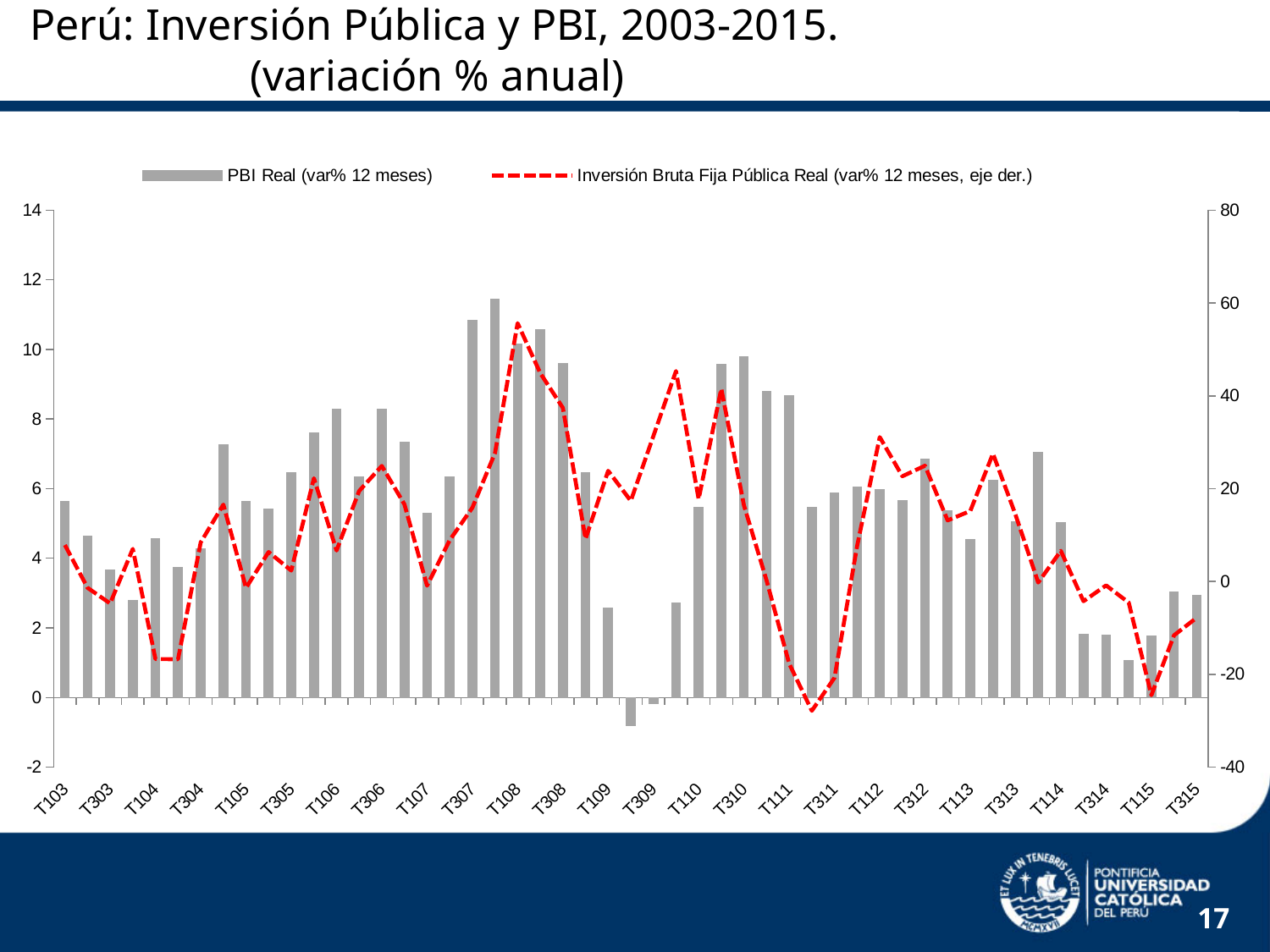
Do the PBI Real bars rise or fall from T114 to T115? Fall Does the Inversión Bruta Fija Pública Real line rise or fall between T309 and T110? Falls Is the PBI Real value for T315 greater or less than 4? less Is the PBI Real value for T103 greater or less than 4? greater Is the Inversión Bruta Fija Pública Real value at T108 greater or less than 40 on the right axis? greater Which series is plotted as grey bars? PBI Real (var% 12 meses) Which is larger, the PBI Real bar for T103 or the PBI Real bar for T315? T103 What kind of chart is shown on the slide? A combined bar and line chart How many series does the legend list? 2 Which series is drawn as a dashed red line? Inversión Bruta Fija Pública Real (var% 12 meses, eje der.)